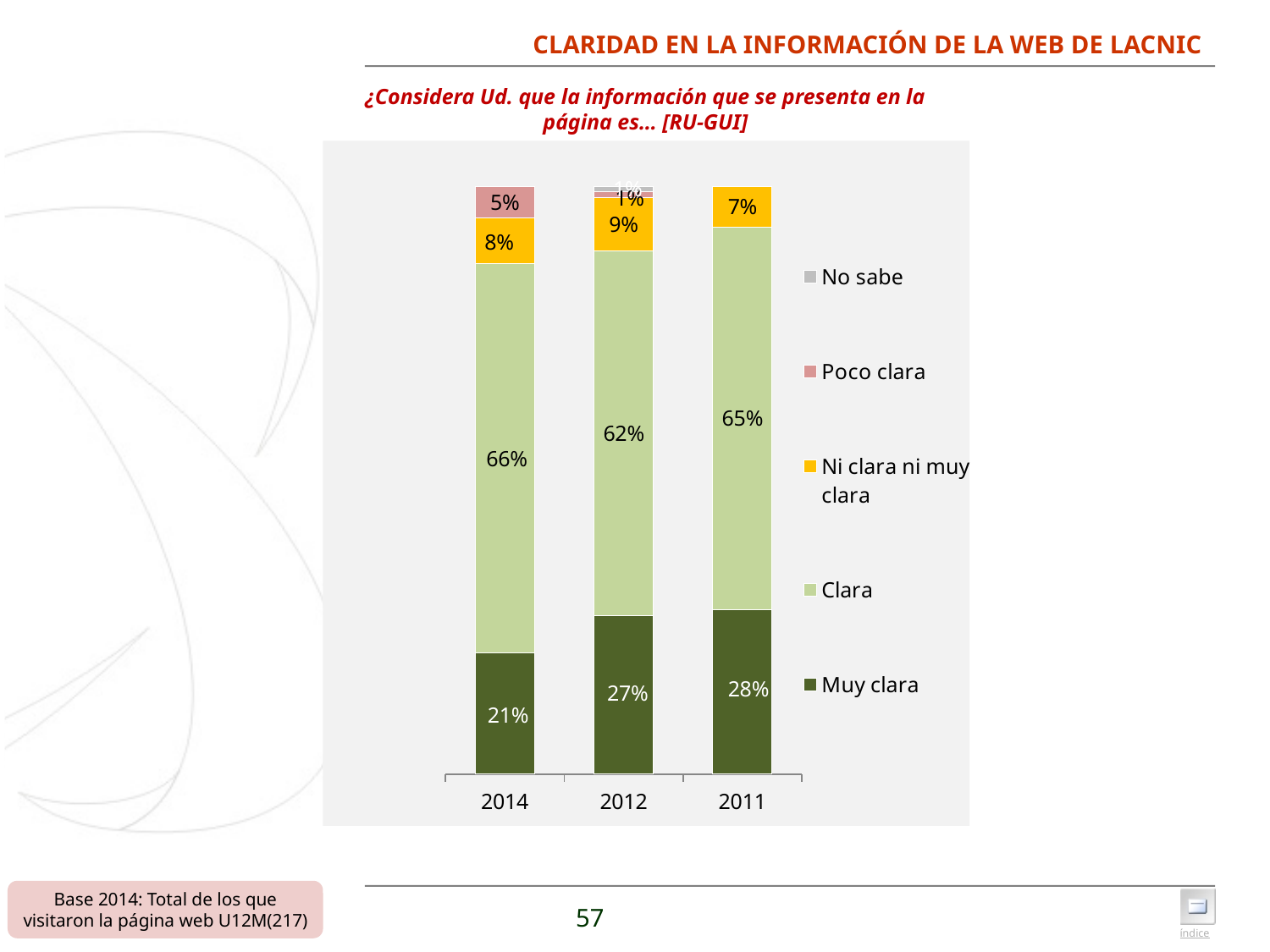
What is the value for "Clara" in 2012? 62% What is the difference between the "Muy clara" values for 2012 and 2014? 6 percentage points How many years are shown on the x axis? 3 What percentage of respondents in 2014 said the information is "Muy clara"? 21% What kind of chart is shown on the slide? Stacked bar chart What is the value for "Ni clara ni muy clara" in 2011? 7% How many series does the legend list? 5 Which is larger: "Ni clara ni muy clara" in 2012 or in 2011? 2012 What is the total of the 2014 stacked bar (Muy clara + Clara + Ni clara ni muy clara + Poco clara)? 100% What is the value for "Poco clara" in 2014? 5% In which year was the "Clara" share highest? 2014 In which year was the "Muy clara" share lowest? 2014